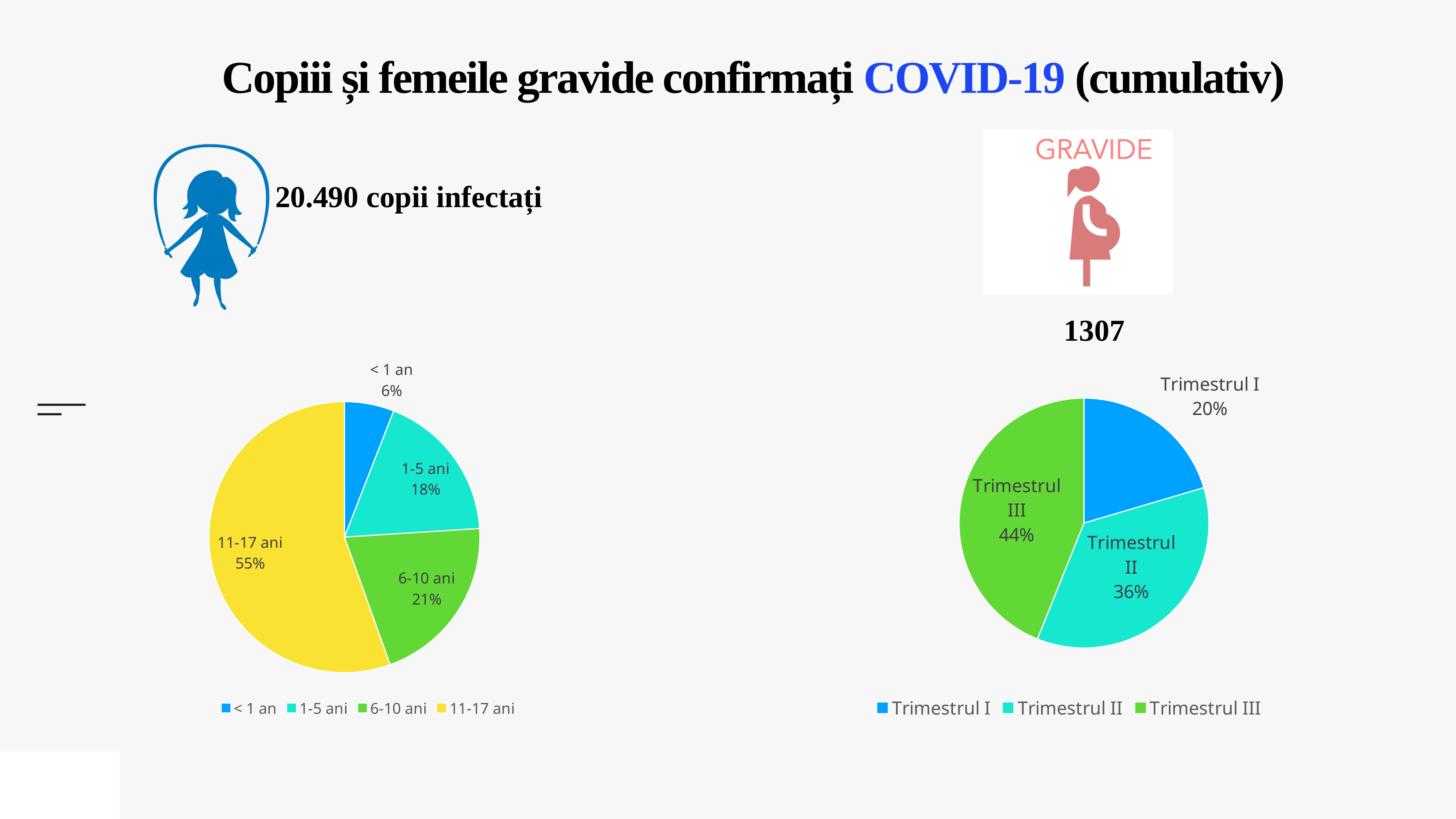
In the right pie chart (pregnant women by trimester), which trimester has the largest share? Trimestrul III In the left pie chart (children by age group), how many age groups are shown? 4 How many entries does the legend of the right pie chart (pregnant women by trimester) list? 3 In the left pie chart (children by age group), what share is shown for the 11-17 ani slice? 55% In the left pie chart (children by age group), which age group has the smallest share? < 1 an In the right pie chart (pregnant women by trimester), what share is shown for Trimestrul II? 36% In the left pie chart (children by age group), what is the difference in percentage points between the 6-10 ani and 1-5 ani slices? 3 What type of chart is used on the right side of the slide for pregnant women by trimester? Pie chart In the right pie chart (pregnant women by trimester), which is larger, Trimestrul I or Trimestrul II? Trimestrul II In the left pie chart (children by age group), what share is shown for the < 1 an slice? 6% In the left pie chart (children by age group), which age group has the largest share? 11-17 ani In the right pie chart (pregnant women by trimester), what is the difference in percentage points between Trimestrul III and Trimestrul I? 24